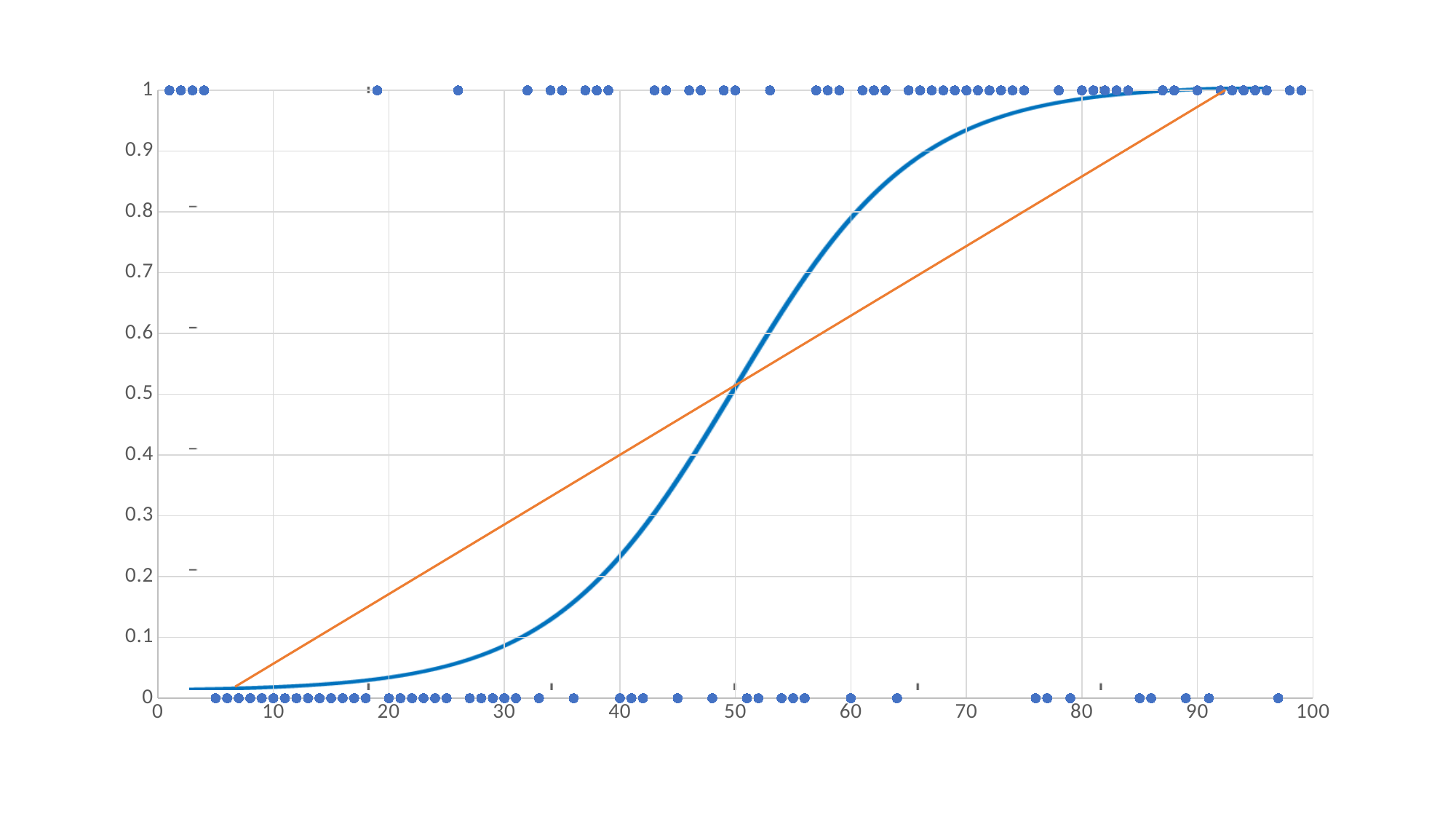
At x = 20, is the value of the blue curve greater or less than 0.1? less What kind of chart is shown on the slide? Scatter chart What is the highest value labelled on the y axis? 1 At x = 80, is the value of the blue curve greater or less than 0.9? greater At x = 70, which is higher: the blue curve or the orange straight line? The blue curve At x = 30, which is higher: the blue curve or the orange straight line? The orange straight line At which two y values do the scattered dots lie? 0 and 1 At x = 70, is the value of the orange straight line greater or less than 0.7? greater What is the highest value labelled on the x axis? 100 Does the orange straight line rise or fall along the x axis? Rises Does the blue S-shaped curve rise or fall as the x axis increases from 0 to 100? Rises